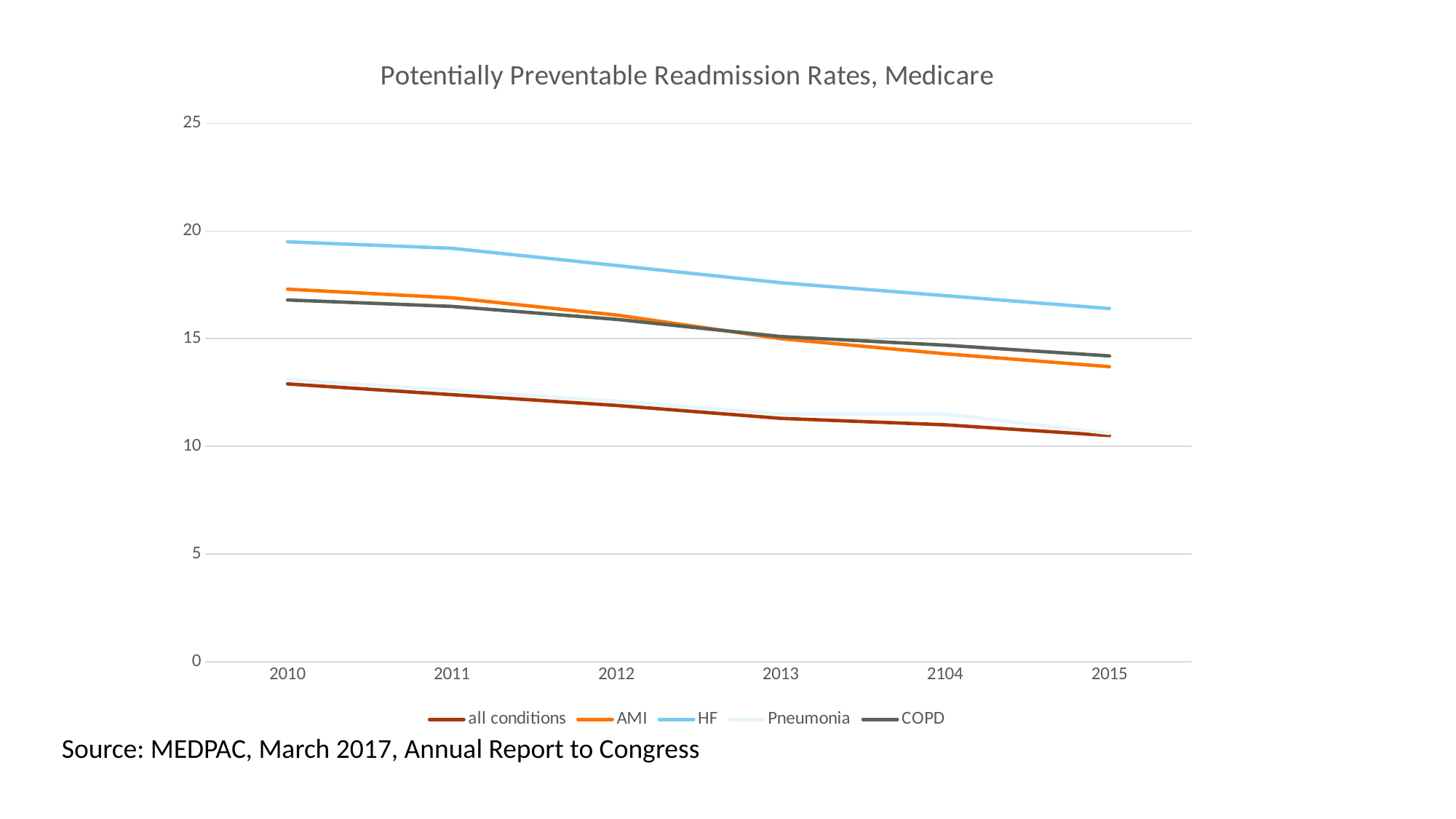
In 2015, which is larger, the value for HF or the value for COPD? HF Is the value for all conditions in 2015 greater or less than 10? greater How many series does the legend list? 5 What is the title of the chart? Potentially Preventable Readmission Rates, Medicare How many years are plotted along the x axis? 6 Is the value for HF in 2010 greater or less than 15? greater What kind of chart is shown on the slide? line chart Is the value for HF in 2015 greater or less than 20? less Does the HF readmission rate rise or fall from 2010 to 2015? fall Which series is shown in light blue in the legend? HF Which series has the highest readmission rate in 2010? HF